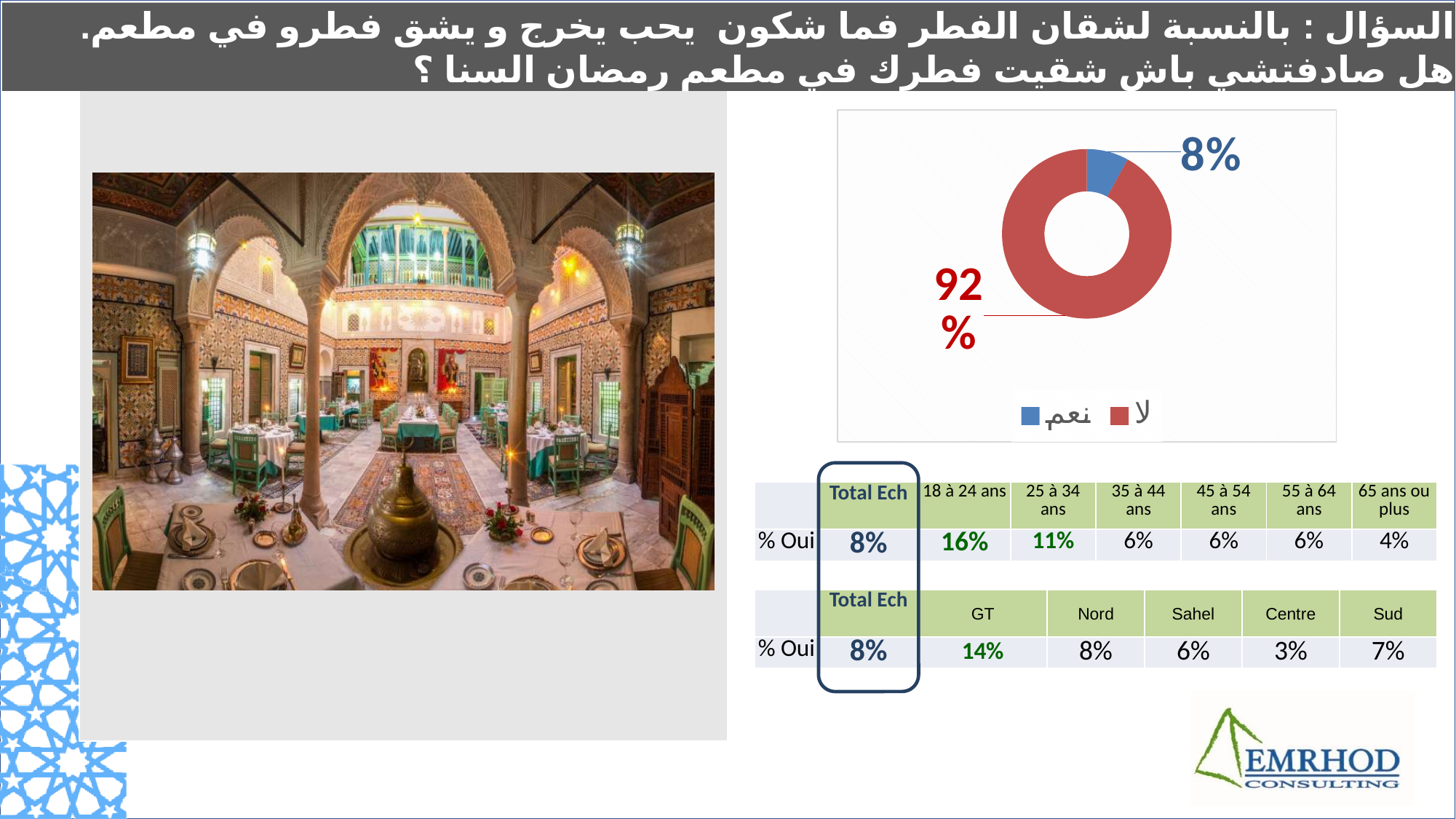
What colour is the لا slice in the pie chart? red What is the value for the slice labelled لا in the pie chart? 92% Which is larger in the pie chart, نعم or لا? لا What colour is the نعم slice in the pie chart? blue Which slice of the pie chart is the smallest? نعم What kind of chart is shown on the slide? doughnut chart How many slices does the pie chart have? 2 How many entries does the legend of the pie chart list? 2 What is the value for the slice labelled نعم in the pie chart? 8% Which slice of the pie chart is the largest? لا What is the difference between the لا slice and the نعم slice in the pie chart? 84%